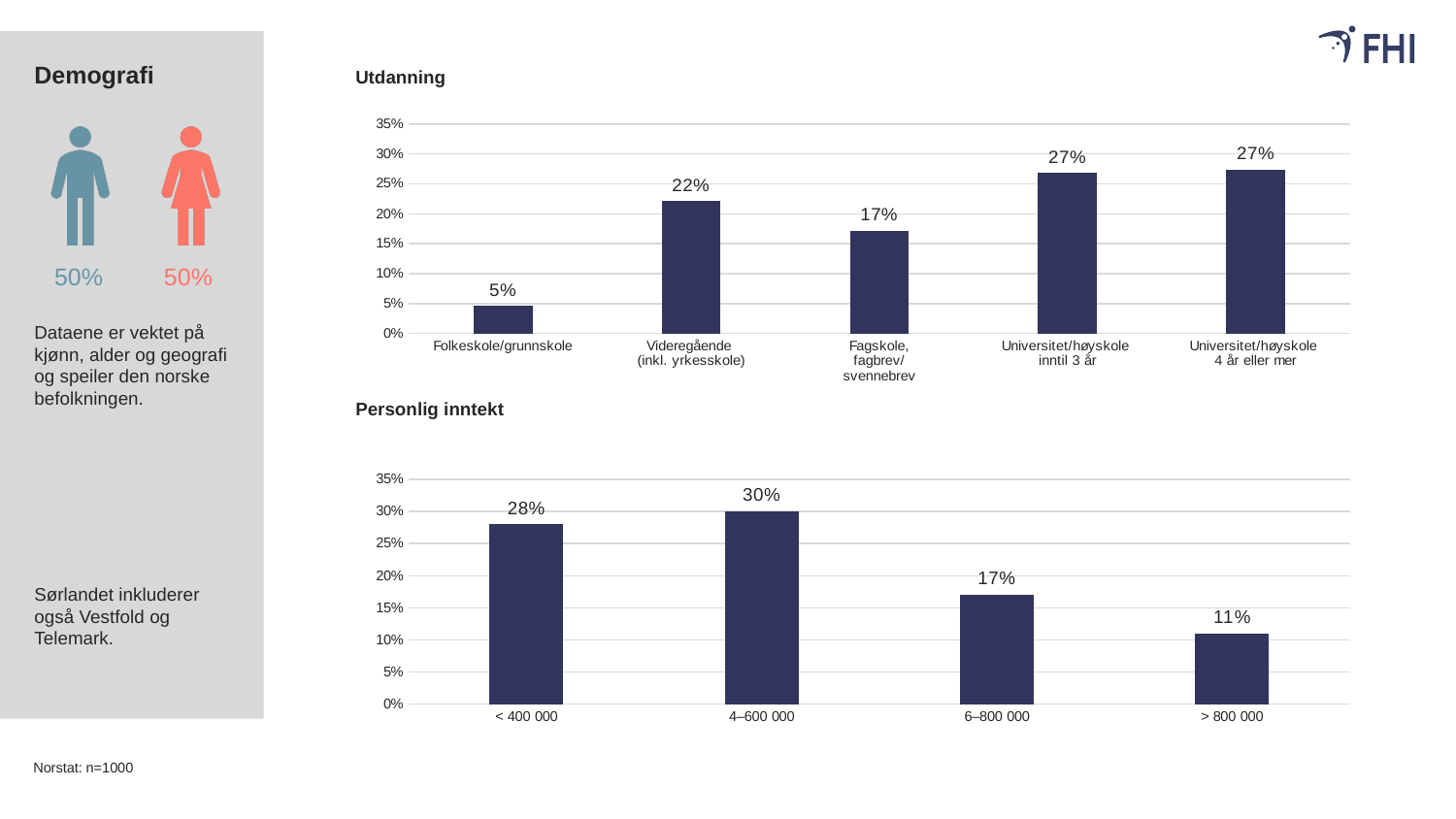
In the Personlig inntekt chart, what is the difference between < 400 000 and 6–800 000? 11% In the Utdanning chart, what is the value for Folkeskole/grunnskole? 5% In the Personlig inntekt chart, what is the value for > 800 000? 11% In the Utdanning chart, what is the difference between Videregående (inkl. yrkesskole) and Fagskole, fagbrev/svennebrev? 5% In the Utdanning chart, what is the value for Videregående (inkl. yrkesskole)? 22% What kind of chart is the Personlig inntekt chart? bar chart In the Personlig inntekt chart, do the values rise or fall from 4–600 000 to > 800 000? fall In the Utdanning chart, how many categories are shown? 5 In the Utdanning chart, is the value for Universitet/høyskole inntil 3 år greater or less than 25%? greater In the Personlig inntekt chart, which is larger, < 400 000 or > 800 000? < 400 000 In the Utdanning chart, which category has the lowest value? Folkeskole/grunnskole In the Personlig inntekt chart, which category has the highest value? 4–600 000